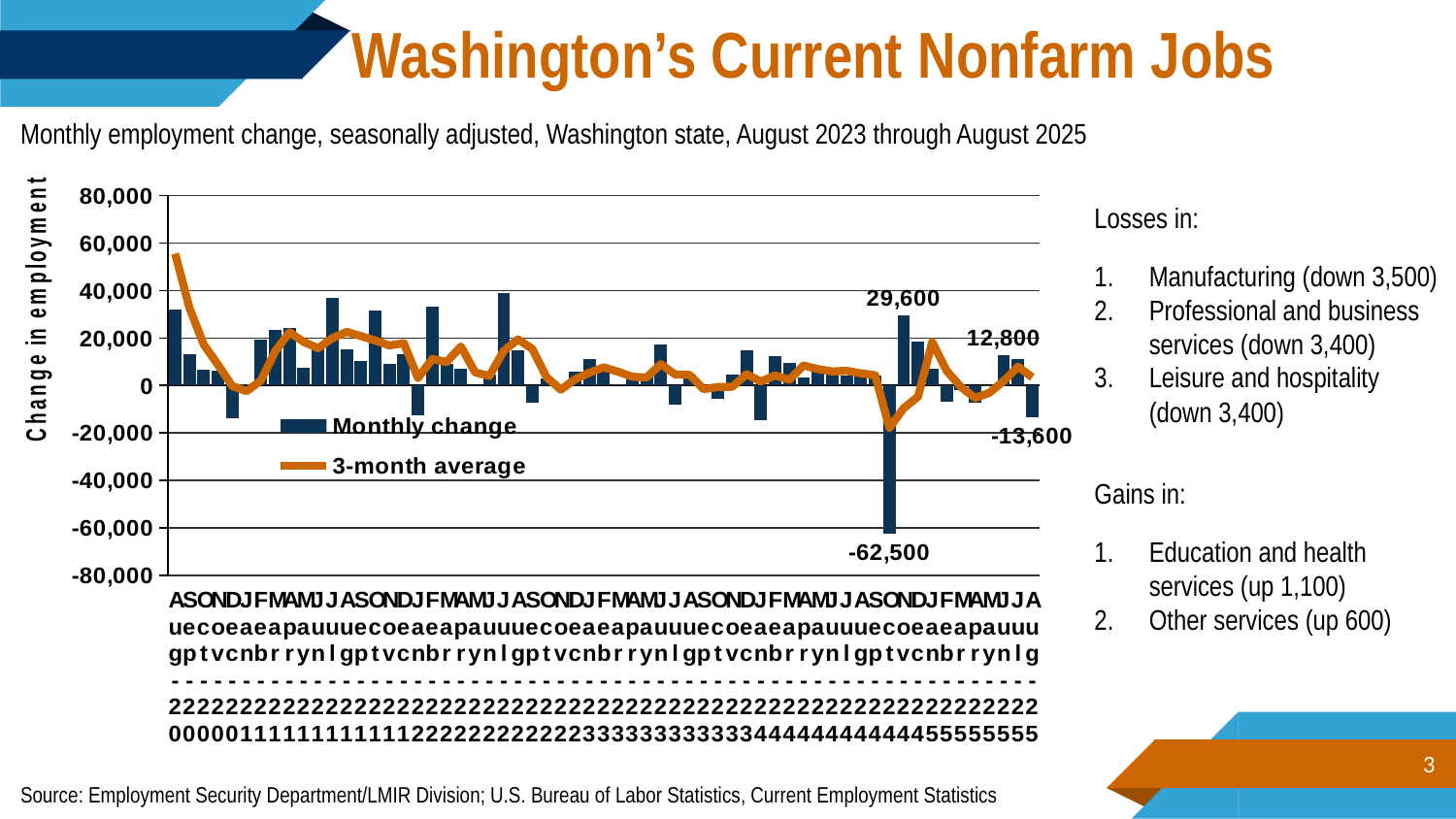
What is the value of the last labeled monthly change bar on the chart? -13,600 Is the value of the lowest bar on the chart greater or less than -60,000? less How many series does the chart legend list? 2 Which is larger, the labeled value 29,600 or the labeled value 12,800? 29,600 Is the value of the tallest bar on the chart greater or less than 20,000? greater What is the difference between the labeled values 29,600 and 12,800? 16,800 What is the highest value shown on the chart's vertical axis? 80,000 What is the lowest monthly change value labeled on the chart? -62,500 What are the two series named in the chart legend? Monthly change; 3-month average What kind of chart is shown on the slide? combination bar and line chart Which series is drawn as the orange line? 3-month average What is the difference between the labeled values 12,800 and -13,600? 26,400